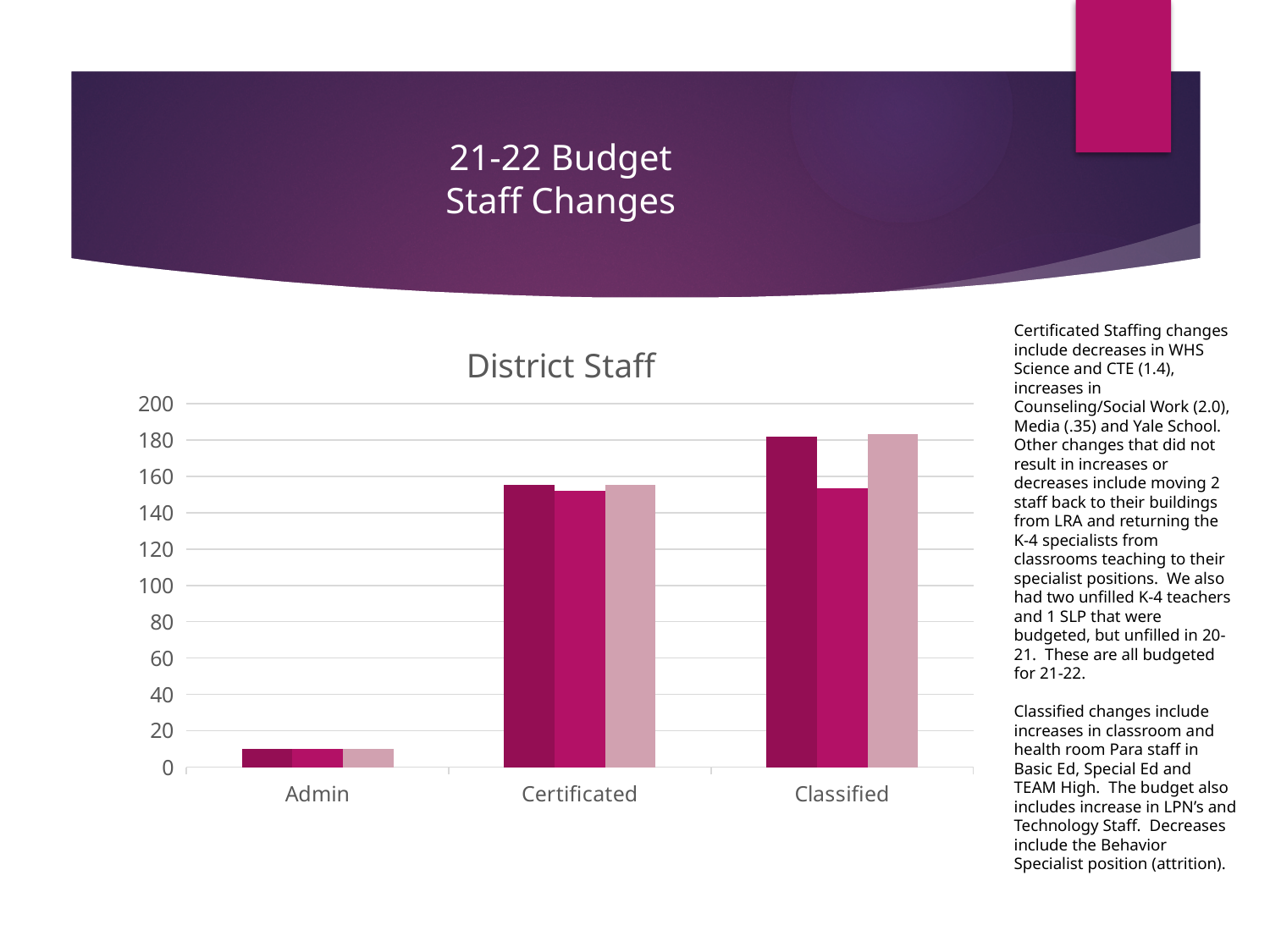
What kind of chart is shown on the slide? bar chart What is the title of the chart on the slide? District Staff How many bars are plotted for each category in the District Staff chart? 3 Are the values for Certificated greater or less than 140? greater Which category has the shortest bars in the District Staff chart? Admin Which category has larger values, Certificated or Admin? Certificated Are the values for Certificated greater or less than 160? less Is the value of the first (leftmost) bar for Classified greater or less than 160? greater How many categories are shown on the x axis of the District Staff chart? 3 Which category has the tallest bars in the District Staff chart? Classified